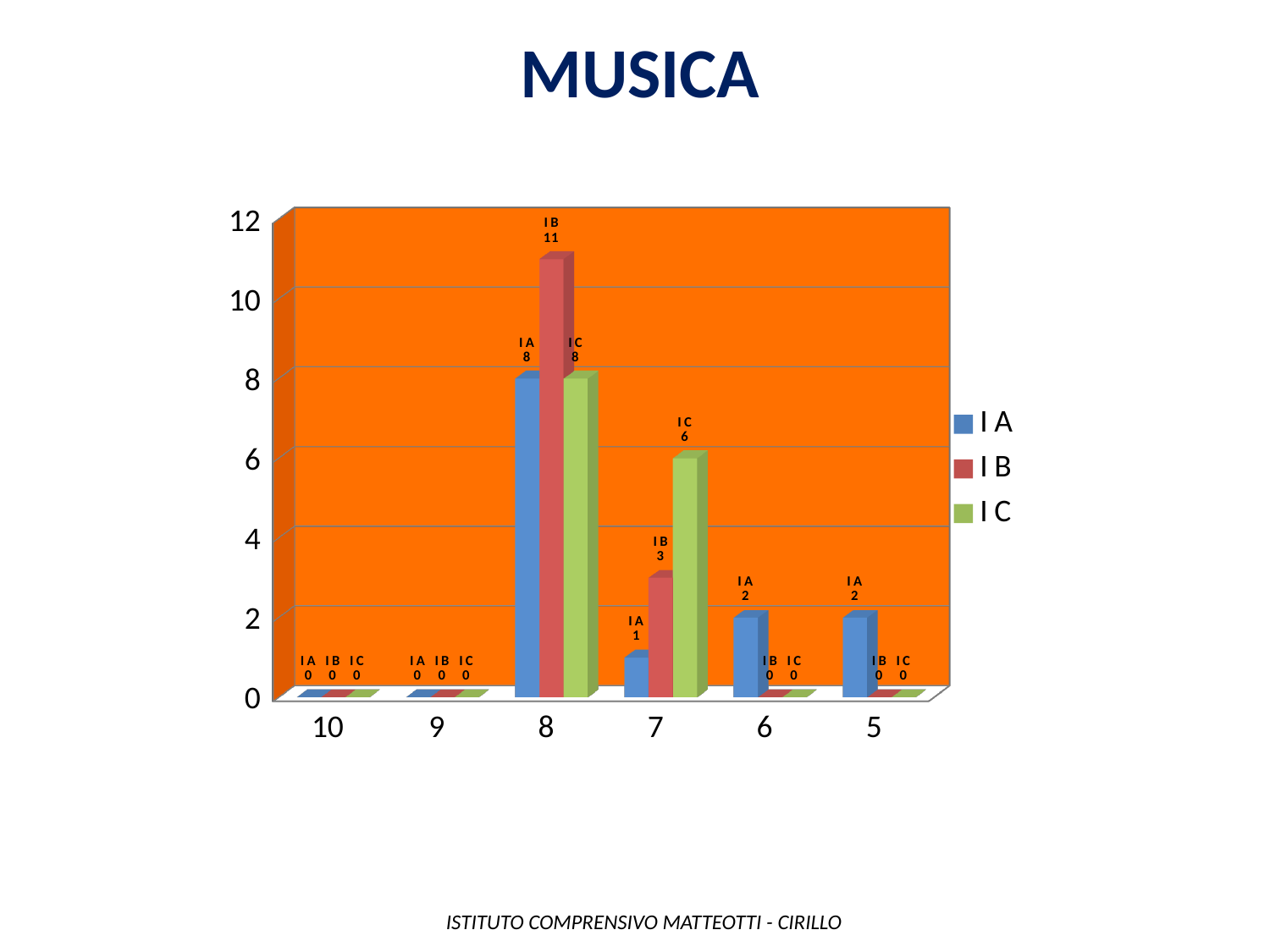
How many series does the legend list? 3 How many grade categories are shown on the x axis? 6 What is the total of the I A, I B and I C values at grade 7? 10 What is the title of the chart? MUSICA Which is larger at grade 7: the value for I B or the value for I C? I C What is the value for I C at grade 7? 6 What is the value for I B at grade 8? 11 Which colour represents the I C series in the legend? green Which grade category has the highest value for I B? 8 What is the value for I A at grade 5? 2 What kind of chart is shown on the slide? bar chart What is the difference between the I B and I A values at grade 8? 3